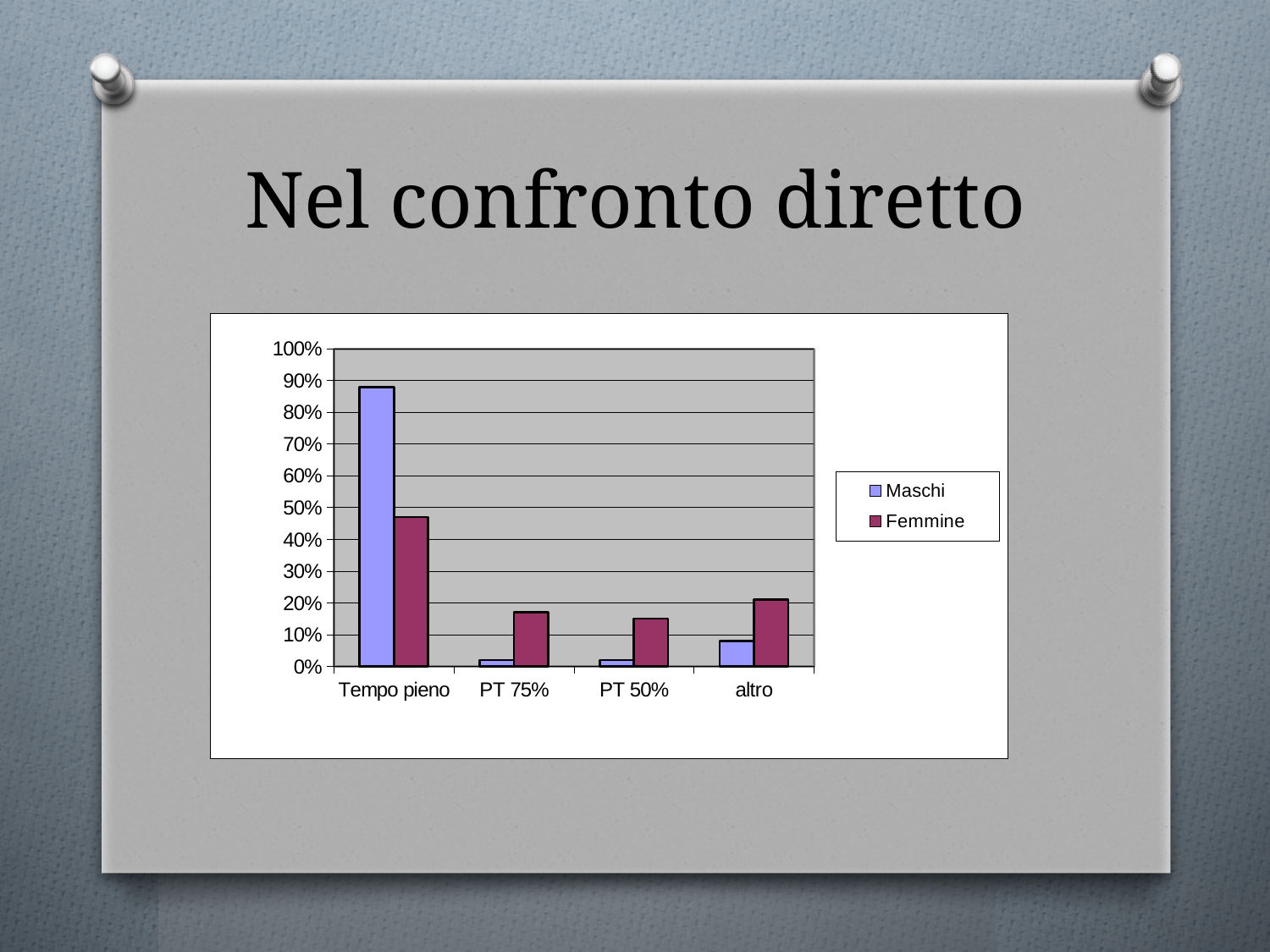
Is the value for Maschi in altro greater or less than 10%? less For PT 75%, which is larger, Maschi or Femmine? Femmine For altro, which is larger, Maschi or Femmine? Femmine For Tempo pieno, which is larger, Maschi or Femmine? Maschi How many series does the legend list? 2 What kind of chart is shown on the slide? bar chart Is the value for Maschi in Tempo pieno greater or less than 80%? greater How many categories are shown on the x axis? 4 What are the two series named in the legend? Maschi and Femmine Which category has the highest value for Femmine? Tempo pieno Is the value for Femmine in Tempo pieno greater or less than 60%? less Which category has the highest value for Maschi? Tempo pieno